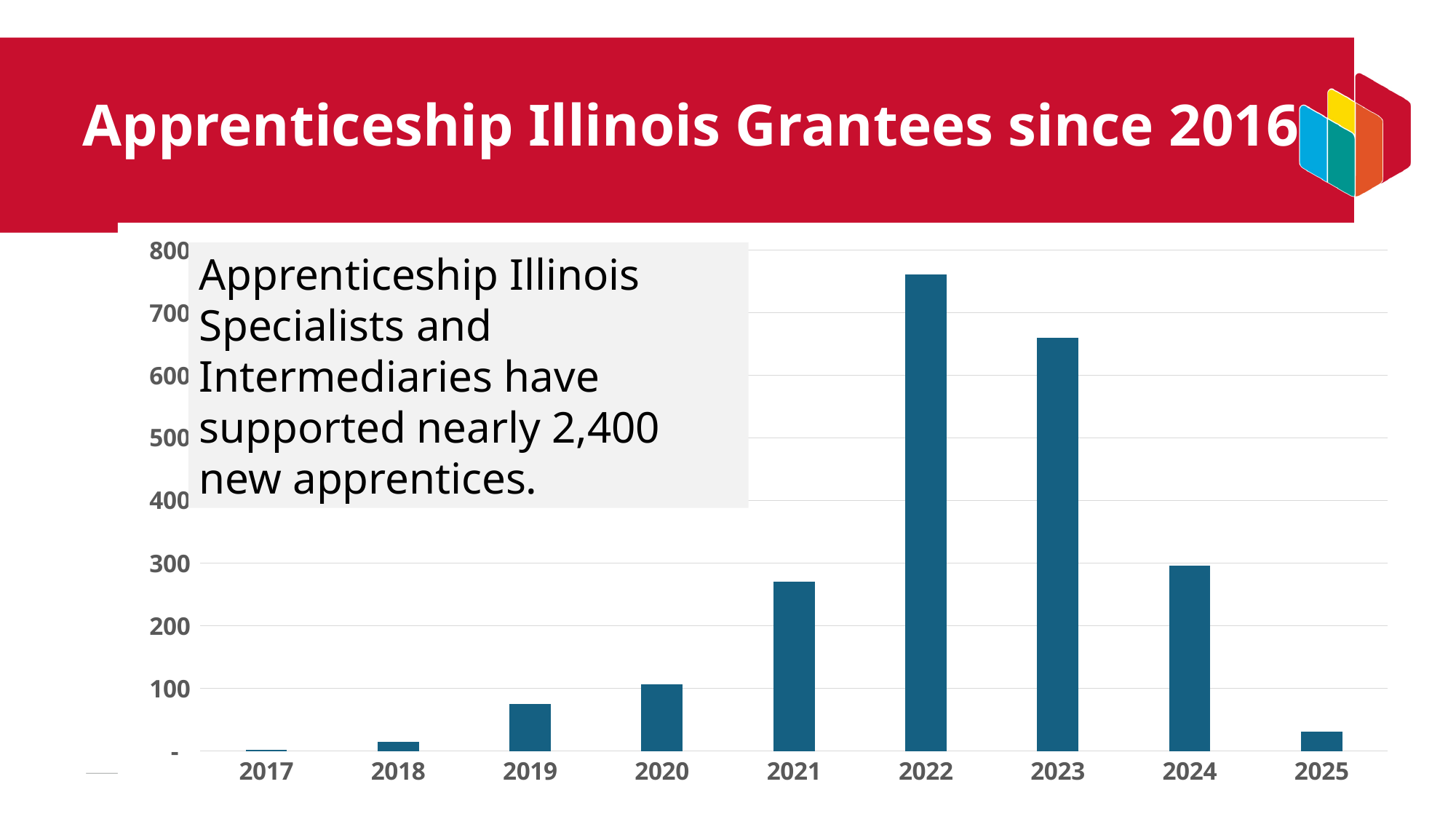
Which year has the highest bar in the chart? 2022 Is the value for 2019 greater or less than 100? less How many years are shown on the x axis of the chart? 9 What kind of chart is shown on the slide? bar chart Is the value for 2022 greater or less than 700? greater Which year has the lowest bar in the chart? 2017 Which year has the larger value, 2022 or 2023? 2022 Is the value for 2023 greater or less than 600? greater What is the title of the slide containing the chart? Apprenticeship Illinois Grantees since 2016 Which year has the larger value, 2019 or 2020? 2020 Do the values rise or fall from 2017 to 2022? rise